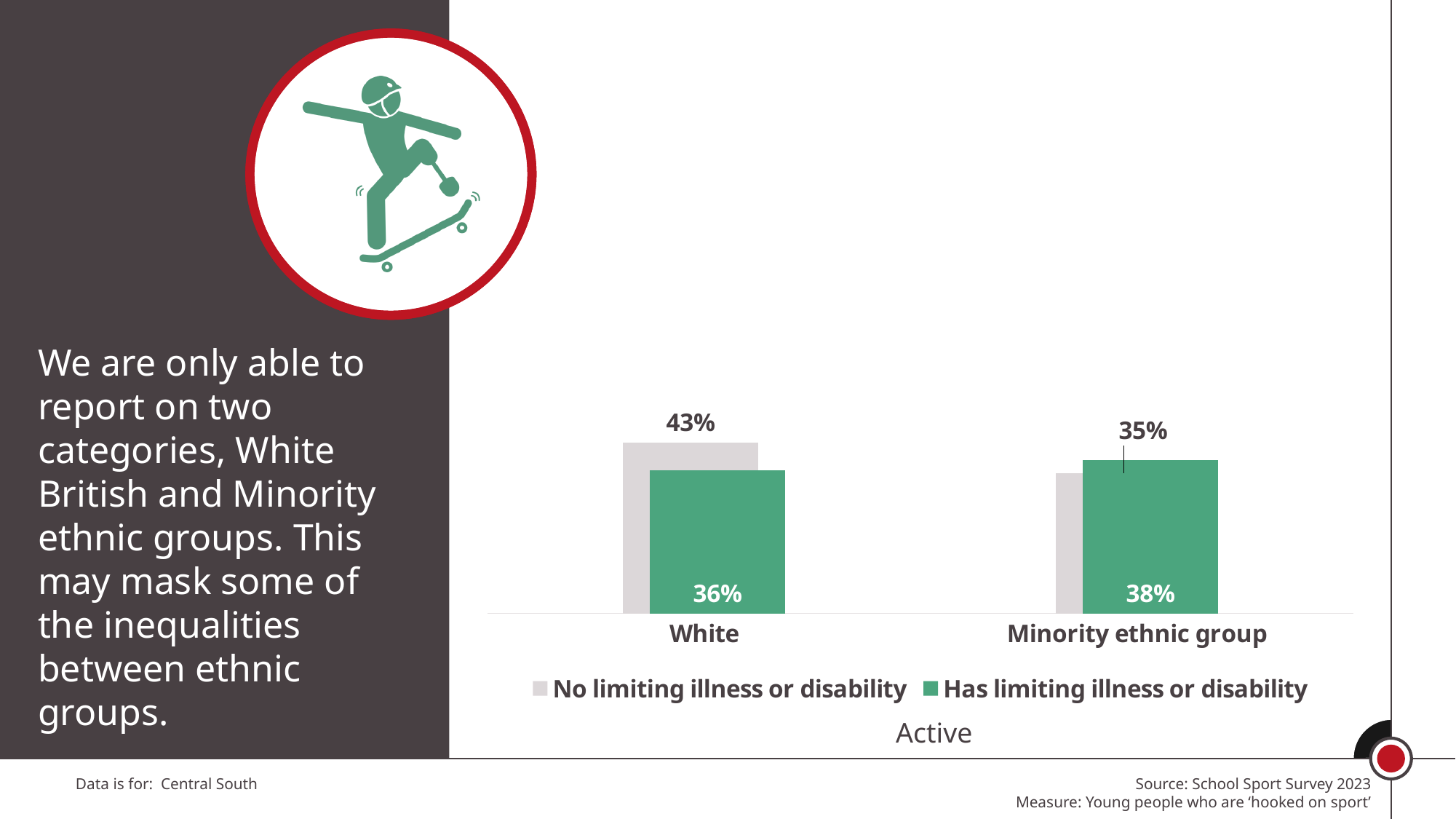
What type of chart is shown on the slide? Bar chart What is the value for Minority ethnic group in the 'Has limiting illness or disability' series? 38% What is the value for Minority ethnic group in the 'No limiting illness or disability' series? 35% What is the difference between the 'Has limiting illness or disability' and 'No limiting illness or disability' values for Minority ethnic group? 3% What is the value for White in the 'Has limiting illness or disability' series? 36% Which category has the highest value in the 'No limiting illness or disability' series? White How many categories are shown on the x axis of the chart? 2 How many series does the chart legend list? 2 Which category has the lowest value in the 'Has limiting illness or disability' series? White What is the value for White in the 'No limiting illness or disability' series? 43% For Minority ethnic group, which series has the larger value: 'No limiting illness or disability' or 'Has limiting illness or disability'? Has limiting illness or disability What is the difference between the 'No limiting illness or disability' and 'Has limiting illness or disability' values for White? 7%